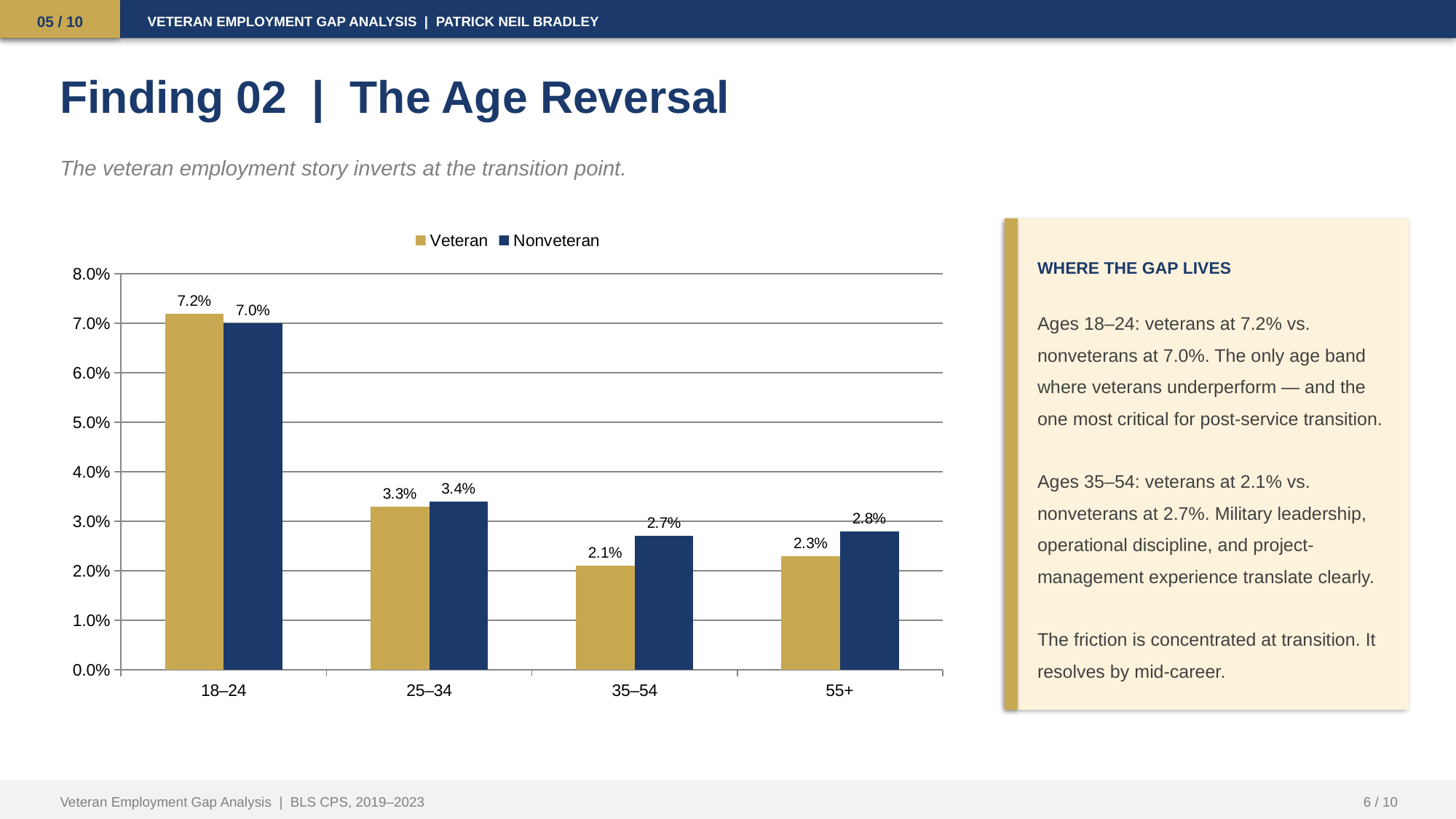
What is the Veteran value for the 18–24 age group? 7.2% How many age groups are shown on the x axis? 4 Which age group has the highest Nonveteran value? 18–24 How many series does the legend list? 2 What is the difference between the Nonveteran and Veteran values for the 35–54 age group? 0.6% Which colour represents the Veteran series in the chart? Gold Is the Nonveteran value for 25–34 greater or less than 3.0%? greater What is the Nonveteran value for the 35–54 age group? 2.7% Which age group has the lowest Veteran value? 35–54 What is the Veteran value for the 55+ age group? 2.3% Which is larger for the 18–24 age group, the Veteran value or the Nonveteran value? Veteran What kind of chart is shown on the slide? Bar chart